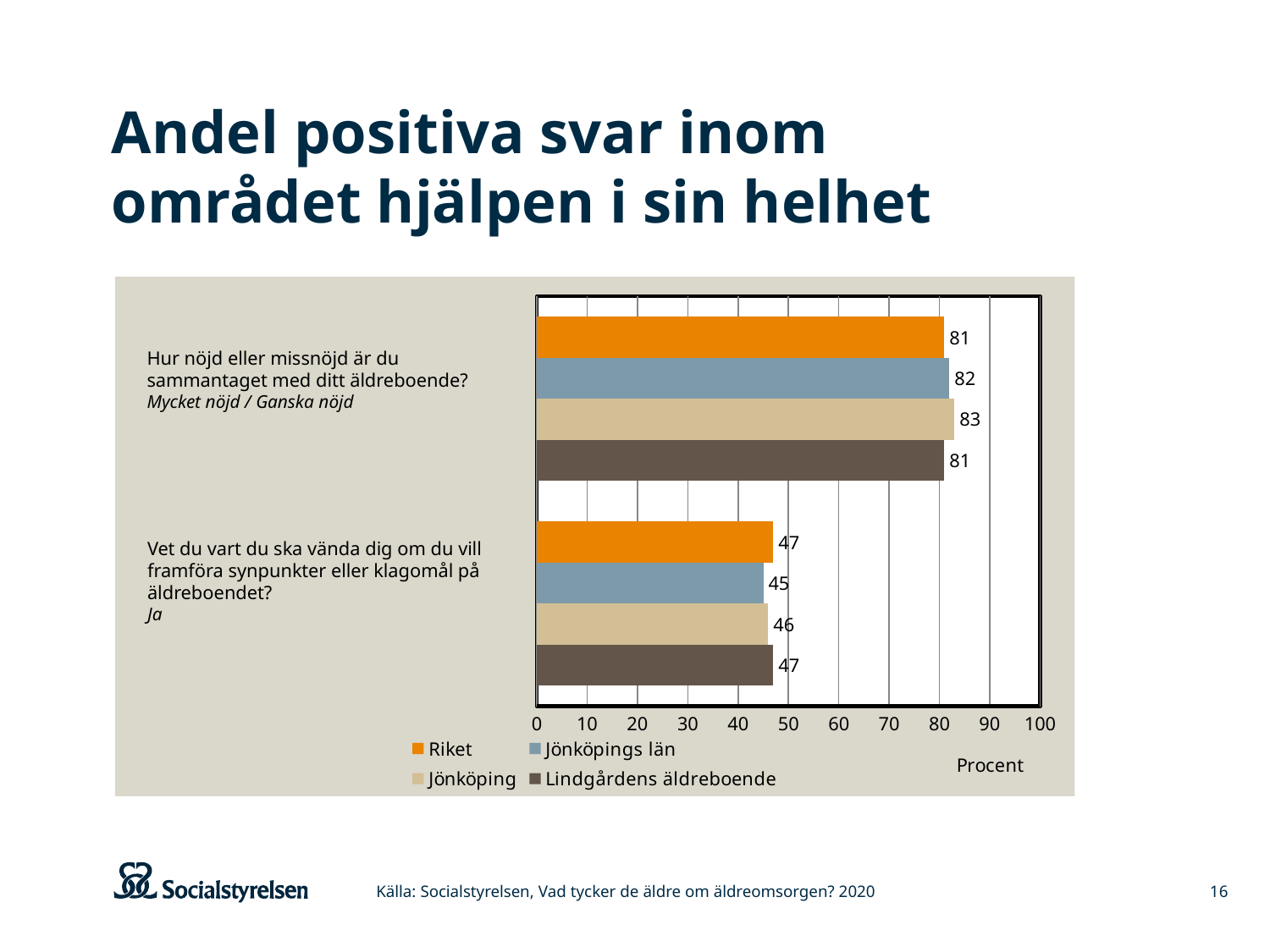
Is the value for Jönköpings län on the question "Hur nöjd eller missnöjd är du sammantaget med ditt äldreboende?" greater or less than 80? greater What value is shown for Riket on the question "Hur nöjd eller missnöjd är du sammantaget med ditt äldreboende?"? 81 Which series has the lowest value on the question "Vet du vart du ska vända dig om du vill framföra synpunkter eller klagomål på äldreboendet?"? Jönköpings län What is the difference between the Jönköping value and the Riket value on the question "Hur nöjd eller missnöjd är du sammantaget med ditt äldreboende?"? 2 What kind of chart is shown on the slide? Bar chart What is the label on the horizontal axis of the chart? Procent What value is shown for Lindgårdens äldreboende on the question "Vet du vart du ska vända dig om du vill framföra synpunkter eller klagomål på äldreboendet?"? 47 What is the difference between the Riket value and the Jönköpings län value on the question "Vet du vart du ska vända dig om du vill framföra synpunkter eller klagomål på äldreboendet?"? 2 Which series has the highest value on the question "Hur nöjd eller missnöjd är du sammantaget med ditt äldreboende?"? Jönköping How many series does the legend list? 4 What value is shown for Jönköping on the question "Hur nöjd eller missnöjd är du sammantaget med ditt äldreboende?"? 83 What value is shown for Jönköpings län on the question "Vet du vart du ska vända dig om du vill framföra synpunkter eller klagomål på äldreboendet?"? 45